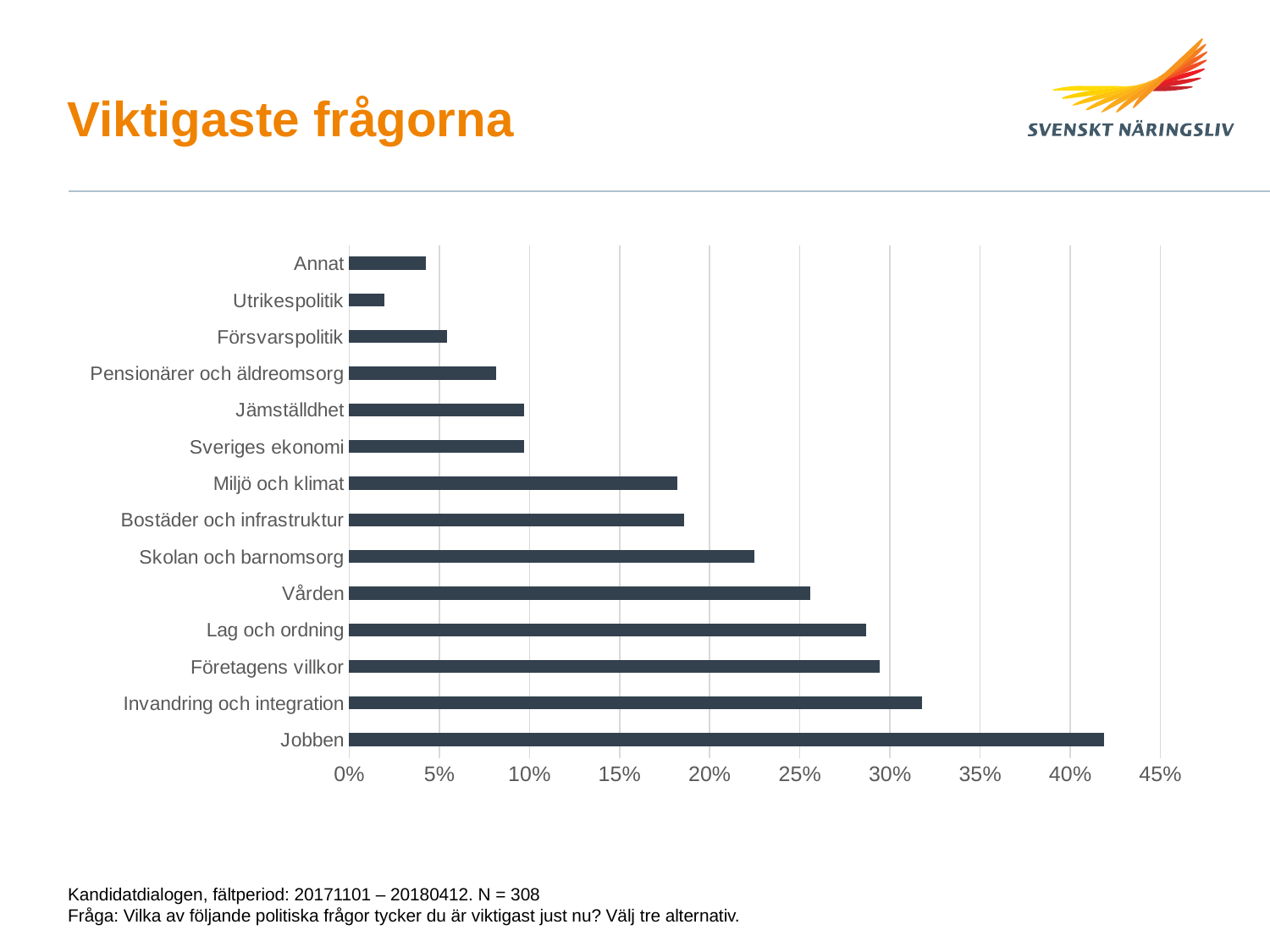
How many categories are shown in the chart? 14 Which category has the lowest value? Utrikespolitik What kind of chart is shown on the slide? bar chart Is the value for Invandring och integration greater or less than 30%? greater Which category has the highest value? Jobben Is the value for Miljö och klimat greater or less than 20%? less Which is larger, the value for Vården or the value for Skolan och barnomsorg? Vården Is the value for Skolan och barnomsorg greater or less than 20%? greater Which is larger, the value for Annat or the value for Utrikespolitik? Annat What is the title of the slide containing the chart? Viktigaste frågorna